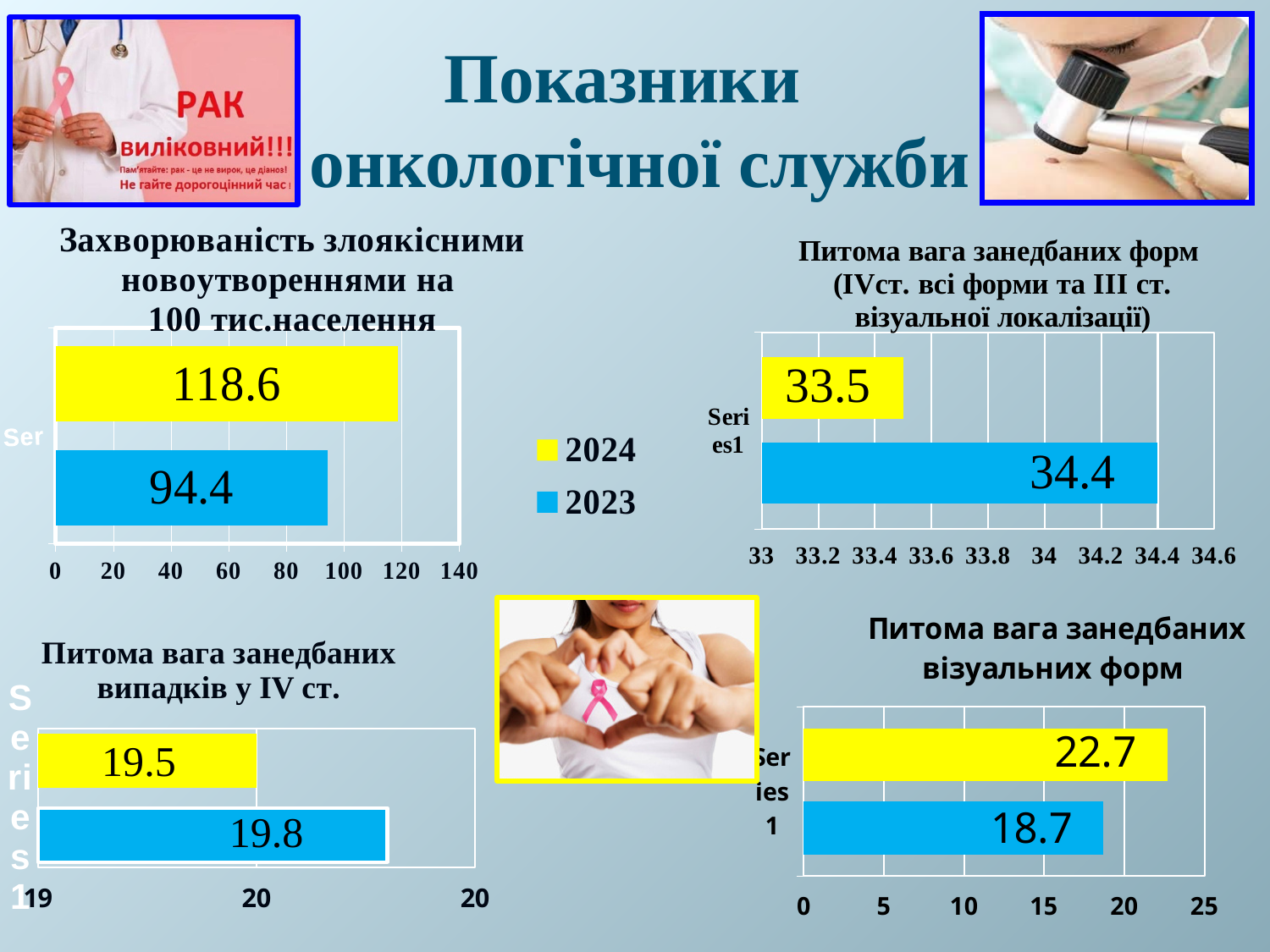
In the chart 'Питома вага занедбаних випадків у IV ст.', what is the value for 2023? 19.8 What kind of chart is 'Захворюваність злоякісними новоутвореннями на 100 тис.населення'? bar chart How many series does the shared legend in the middle of the slide list? 2 In the chart 'Захворюваність злоякісними новоутвореннями на 100 тис.населення', what is the value for 2023? 94.4 In the chart 'Питома вага занедбаних візуальних форм', what is the difference between the 2024 and 2023 values? 4.0 In the chart 'Питома вага занедбаних візуальних форм', which year has the lower value? 2023 In the chart 'Питома вага занедбаних випадків у IV ст.', what is the value for 2024? 19.5 In the chart 'Питома вага занедбаних форм (IVст. всі форми та III ст. візуальної локалізації)', what is the value for 2023? 34.4 In the chart 'Питома вага занедбаних візуальних форм', what is the value for 2024? 22.7 In the chart 'Захворюваність злоякісними новоутвореннями на 100 тис.населення', what is the difference between the 2024 and 2023 values? 24.2 In the chart 'Захворюваність злоякісними новоутвореннями на 100 тис.населення', what is the value for 2024? 118.6 In the chart 'Питома вага занедбаних форм (IVст. всі форми та III ст. візуальної локалізації)', which year has the higher value, 2024 or 2023? 2023